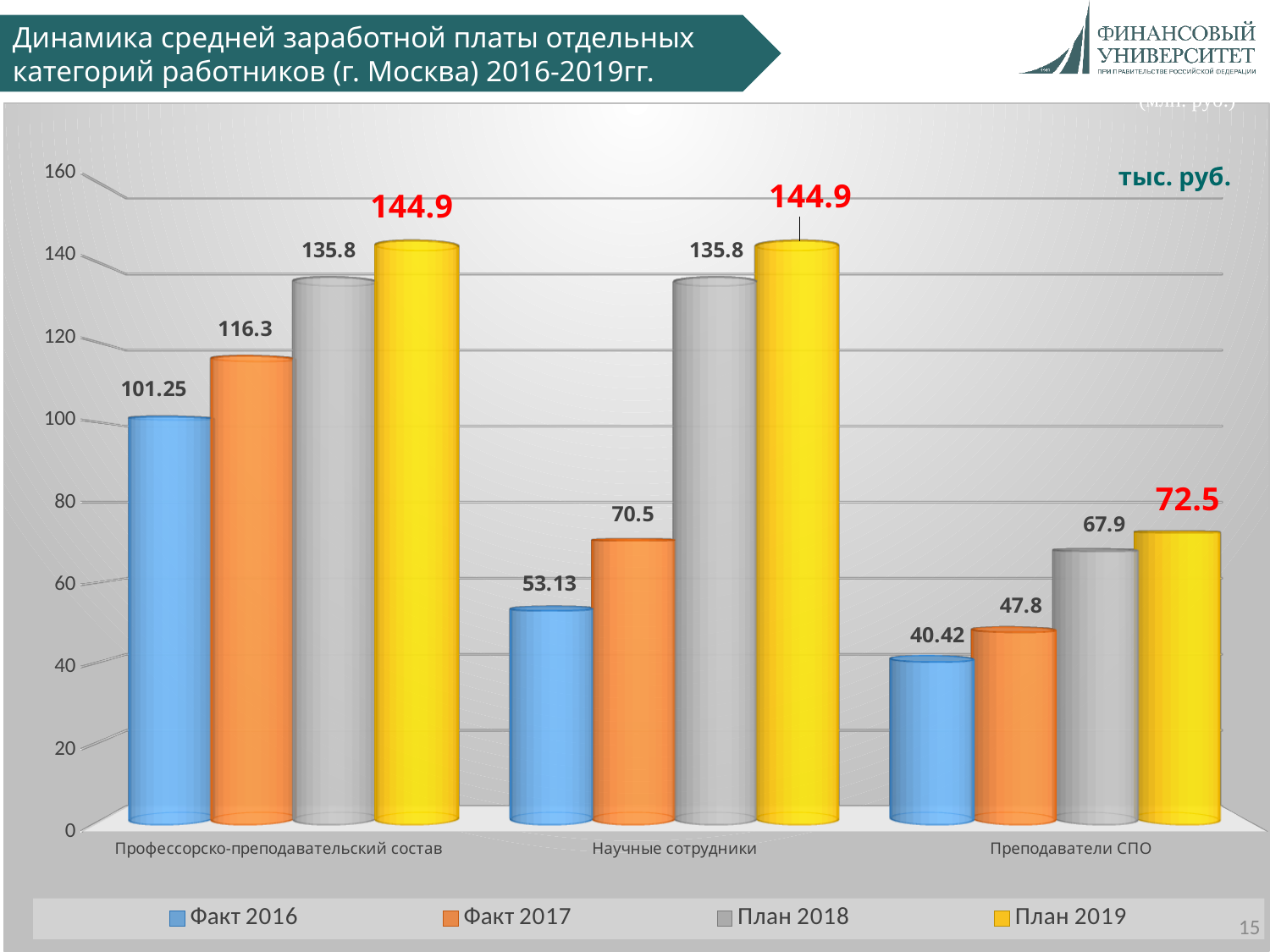
What is the value for Факт 2016 for Профессорско-преподавательский состав? 101.25 How many series does the legend list? 4 Which category has the lowest Факт 2016 value? Преподаватели СПО What is the value for План 2019 for Преподаватели СПО? 72.5 What is the difference between Факт 2017 and Факт 2016 for Научные сотрудники? 17.37 What is the value for План 2018 for Преподаватели СПО? 67.9 What is the difference between План 2019 and План 2018 for Профессорско-преподавательский состав? 9.1 What is the value for Факт 2017 for Научные сотрудники? 70.5 What kind of chart is shown on the slide? Bar chart How many categories are shown on the x axis? 3 Which series has the highest value for Научные сотрудники? План 2019 Which is larger: Факт 2017 for Преподаватели СПО or Факт 2016 for Научные сотрудники? Факт 2016 for Научные сотрудники